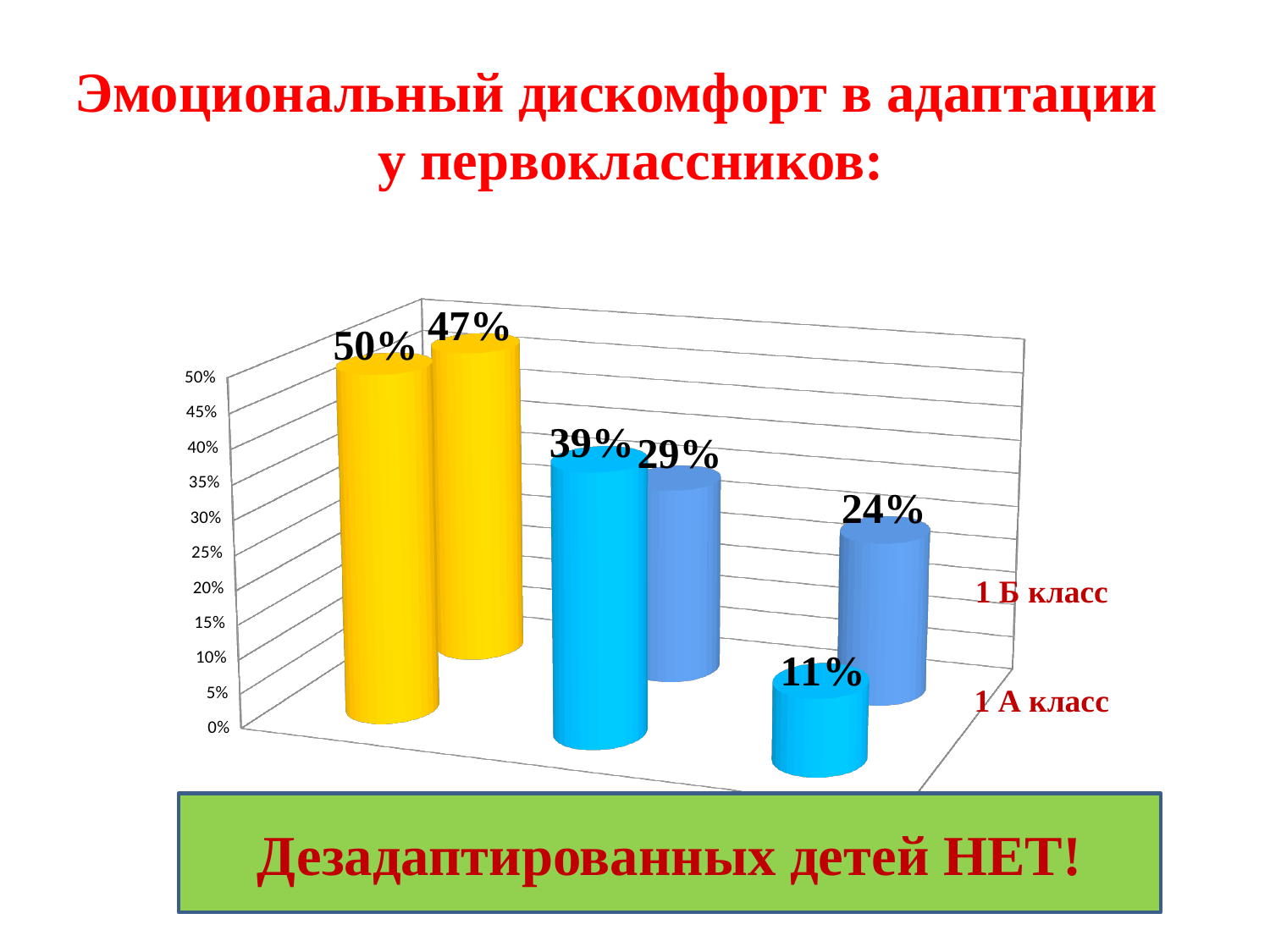
Do the values for 1 А класс rise or fall from left to right? fall What is the value of the first (leftmost) bar for 1 А класс? 50% For the third (rightmost) group of bars, which class has the larger value, 1 А класс or 1 Б класс? 1 Б класс How many bars are plotted on the chart in total? 6 What is the value of the middle bar for 1 Б класс? 29% What is the difference between the middle bars for 1 А класс (39%) and 1 Б класс (29%)? 10% What is the value of the first (leftmost) bar for 1 Б класс? 47% What is the value of the third (rightmost) bar for 1 Б класс? 24% What is the lowest value shown on the chart? 11% What is the value of the third (rightmost) bar for 1 А класс? 11% What kind of chart is shown on the slide? bar chart What is the highest value shown on the chart? 50%